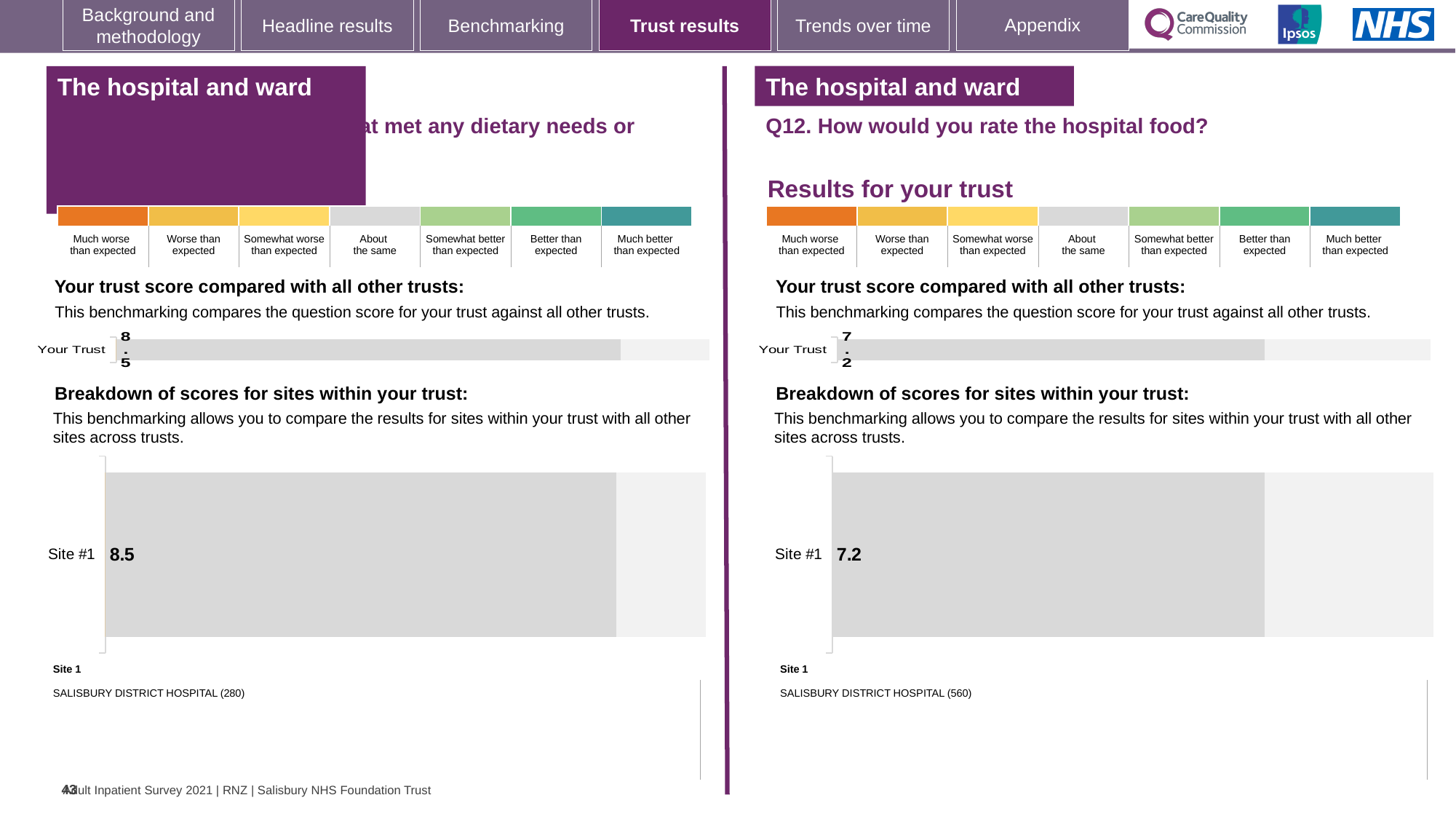
What is the difference between the Site #1 score on the left-hand panel and the Site #1 score on the right-hand panel (Q12)? 1.3 How many sites are shown in the breakdown of scores on the left-hand panel? 1 On the right-hand panel (Q12. How would you rate the hospital food?), what is the score shown for Your Trust? 7.2 On the left-hand panel, what is the score shown for Site #1? 8.5 On the right-hand panel (Q12), which site is listed as Site 1? SALISBURY DISTRICT HOSPITAL (560) Which is larger: the Your Trust score on the left-hand panel or the Your Trust score on the right-hand panel (Q12)? Left-hand panel Is the Your Trust score on the right-hand panel (Q12) greater or less than 8? less On the right-hand panel (Q12), what is the score shown for Site #1? 7.2 How many sites are shown in the breakdown of scores on the right-hand panel (Q12)? 1 On the left-hand panel, what is the score shown for Your Trust? 8.5 On the left-hand panel, which site is listed as Site 1? SALISBURY DISTRICT HOSPITAL (280) What kind of chart is used to show the Site #1 score on the right-hand panel (Q12)? Bar chart